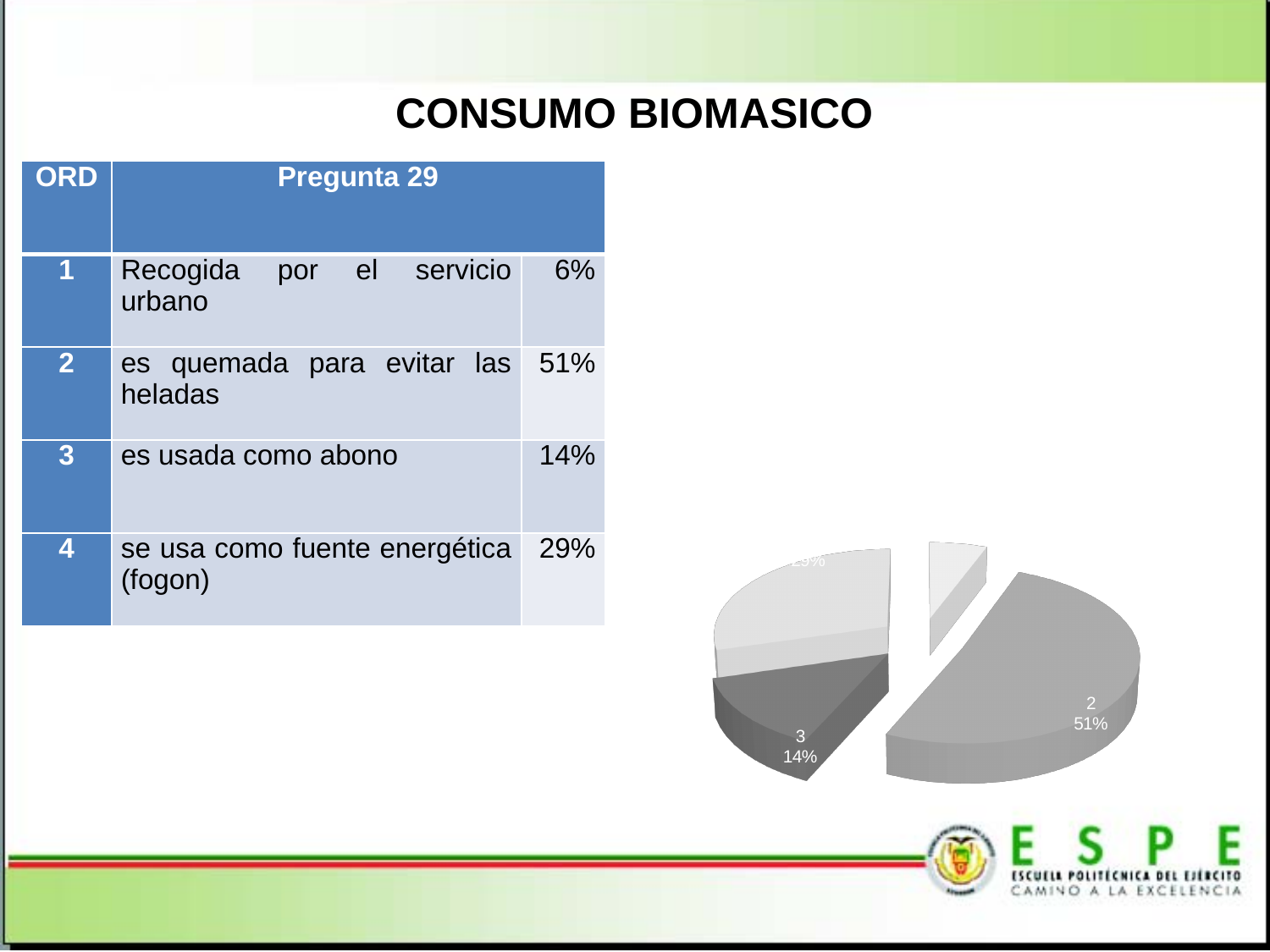
What share of the pie does slice 2 represent? 51% What is the title shown at the top of the slide above the chart? CONSUMO BIOMASICO Does slice 2 of the pie chart account for more or less than half of the total? more How many slices does the pie chart have? 4 What percentage is shown for slice 3 in the pie chart? 14% According to the table on the slide, what percentage corresponds to 'es usada como abono' (ORD 3)? 14% What percentage is shown for slice 2 in the pie chart? 51% Which slice of the pie chart is the smallest? 1 Which is larger in the pie chart, slice 2 or slice 3? 2 Which slice of the pie chart is the largest? 2 What kind of chart is shown on the slide? pie chart What is the difference in percentage points between slice 2 and slice 3 in the pie chart? 37